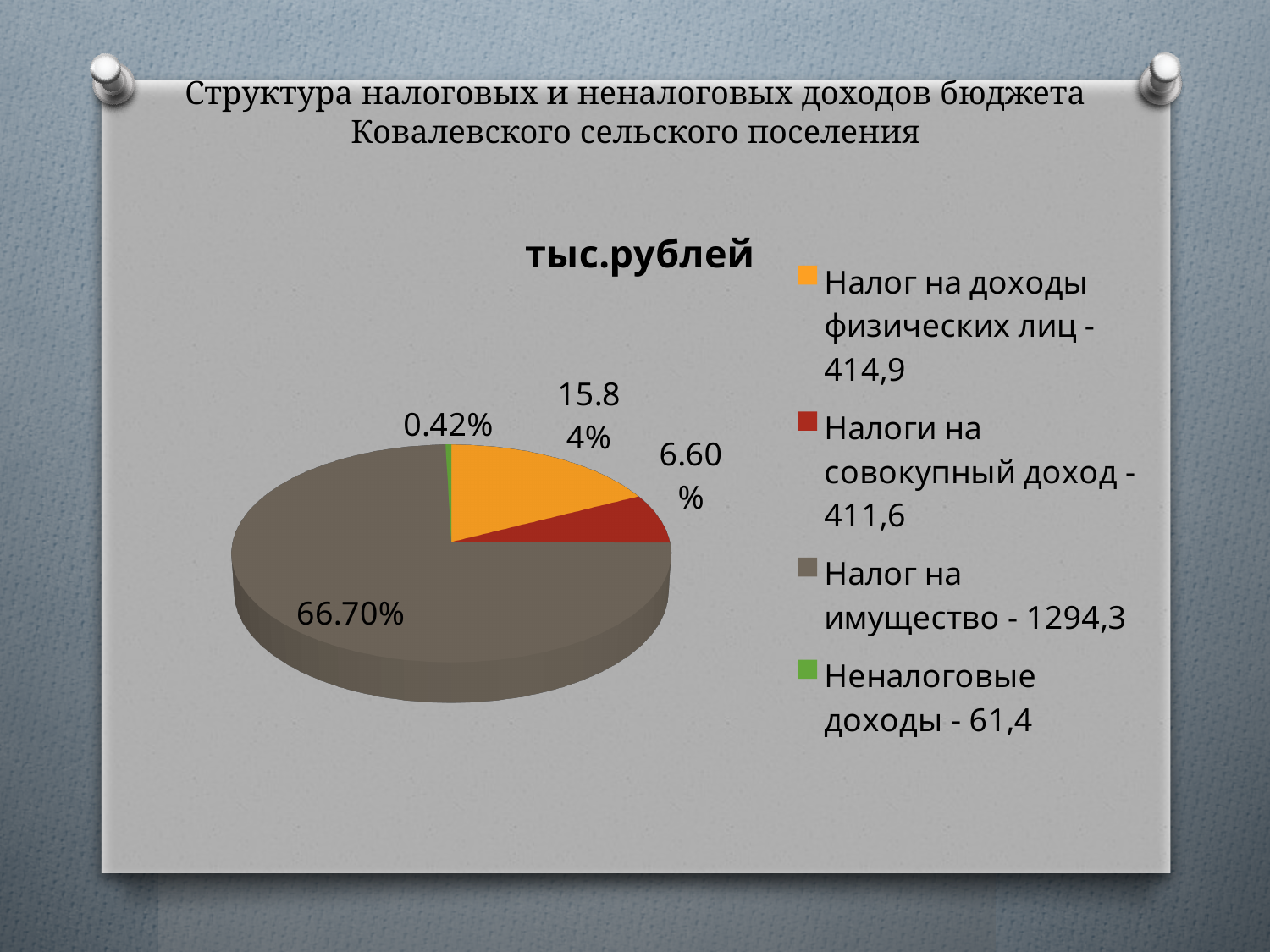
What share of the pie does Налог на имущество take? 66.70% Which category has the smallest slice of the pie? Неналоговые доходы What kind of chart is shown on the slide? pie chart What value is listed in the legend for Неналоговые доходы? 61,4 How many slices does the pie chart have? 4 What share of the pie does Налог на доходы физических лиц take? 15.84% What value is listed in the legend for Налог на имущество? 1294,3 Which category has the largest slice of the pie? Налог на имущество What is the title of the chart? тыс.рублей What share of the pie does Налоги на совокупный доход take? 6.60% Which colour represents Налоги на совокупный доход in the pie chart? red